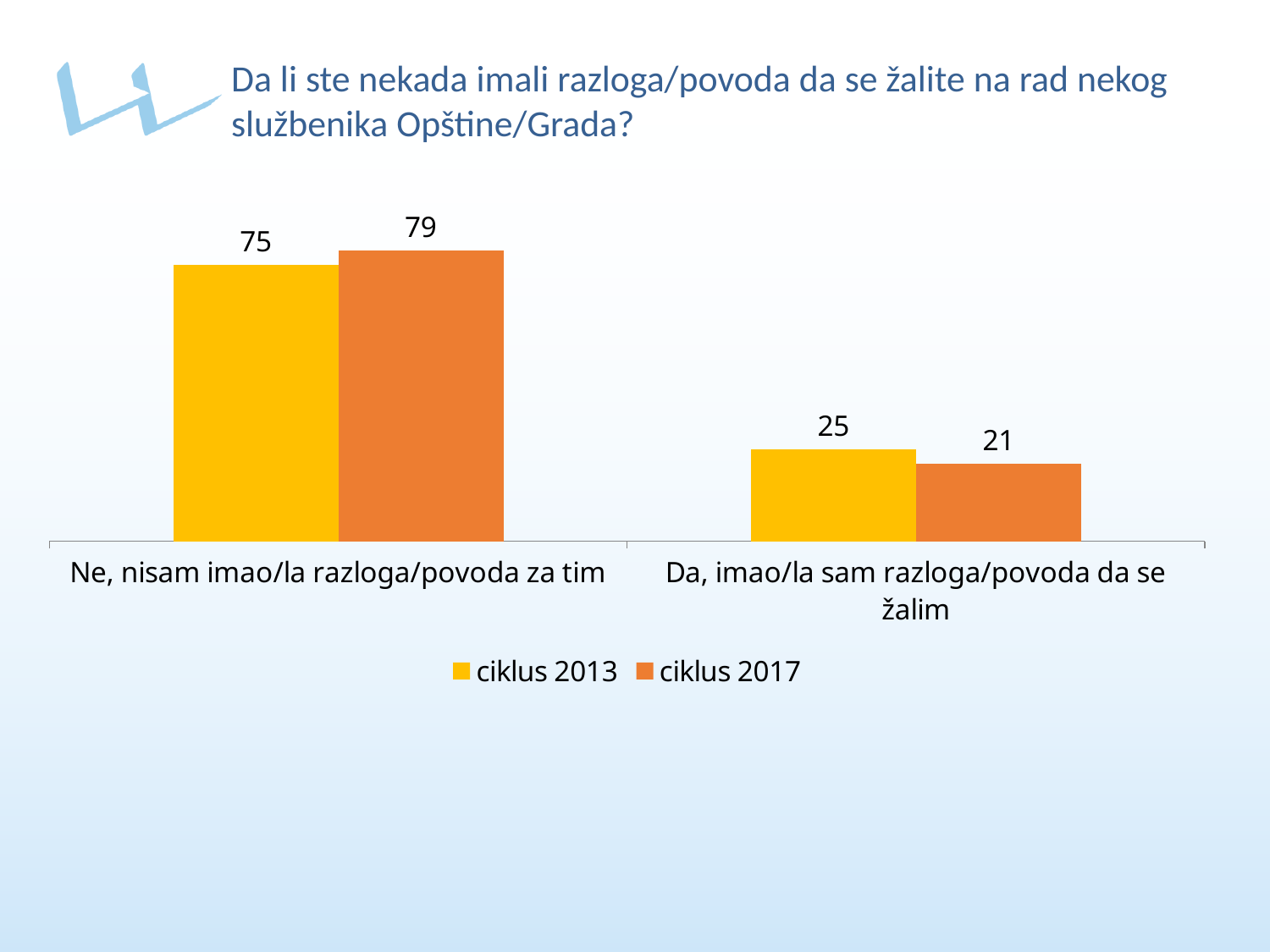
What kind of chart is shown on the slide? bar chart For "Da, imao/la sam razloga/povoda da se žalim", which series has the larger value, ciklus 2013 or ciklus 2017? ciklus 2013 Which category has the lowest value in the ciklus 2013 series? Da, imao/la sam razloga/povoda da se žalim How many categories are shown on the x axis? 2 What is the difference between the ciklus 2013 and ciklus 2017 values for "Da, imao/la sam razloga/povoda da se žalim"? 4 What is the difference between the ciklus 2017 and ciklus 2013 values for "Ne, nisam imao/la razloga/povoda za tim"? 4 How many series does the legend list? 2 Which category has the highest value in the ciklus 2017 series? Ne, nisam imao/la razloga/povoda za tim What is the value for "Da, imao/la sam razloga/povoda da se žalim" in the ciklus 2017 series? 21 What is the value for "Da, imao/la sam razloga/povoda da se žalim" in the ciklus 2013 series? 25 What is the value for "Ne, nisam imao/la razloga/povoda za tim" in the ciklus 2013 series? 75 What is the value for "Ne, nisam imao/la razloga/povoda za tim" in the ciklus 2017 series? 79